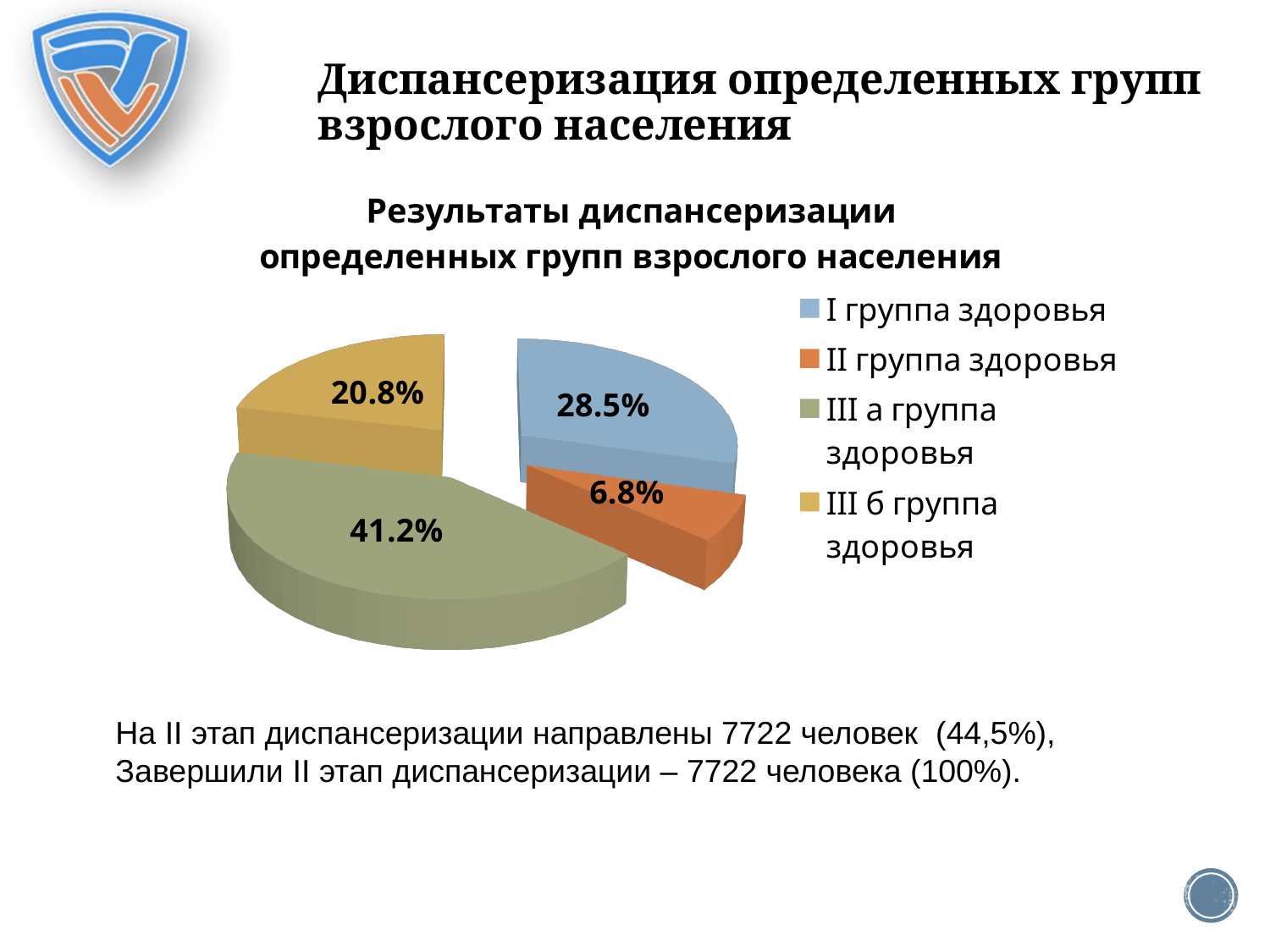
Which is larger: the share of I группа здоровья or III б группа здоровья? I группа здоровья What share of the pie does III а группа здоровья have? 41.2% What share of the pie does I группа здоровья have? 28.5% What share of the pie does III б группа здоровья have? 20.8% What kind of chart is shown on the slide? Pie chart Which health group has the largest share of the pie? III а группа здоровья How many slices does the pie chart have? 4 What share of the pie does II группа здоровья have? 6.8% Which health group has the smallest share of the pie? II группа здоровья What is the difference between the shares of III а группа здоровья and I группа здоровья? 12.7% How many entries does the legend list? 4 What is the title of the chart? Результаты диспансеризации определенных групп взрослого населения